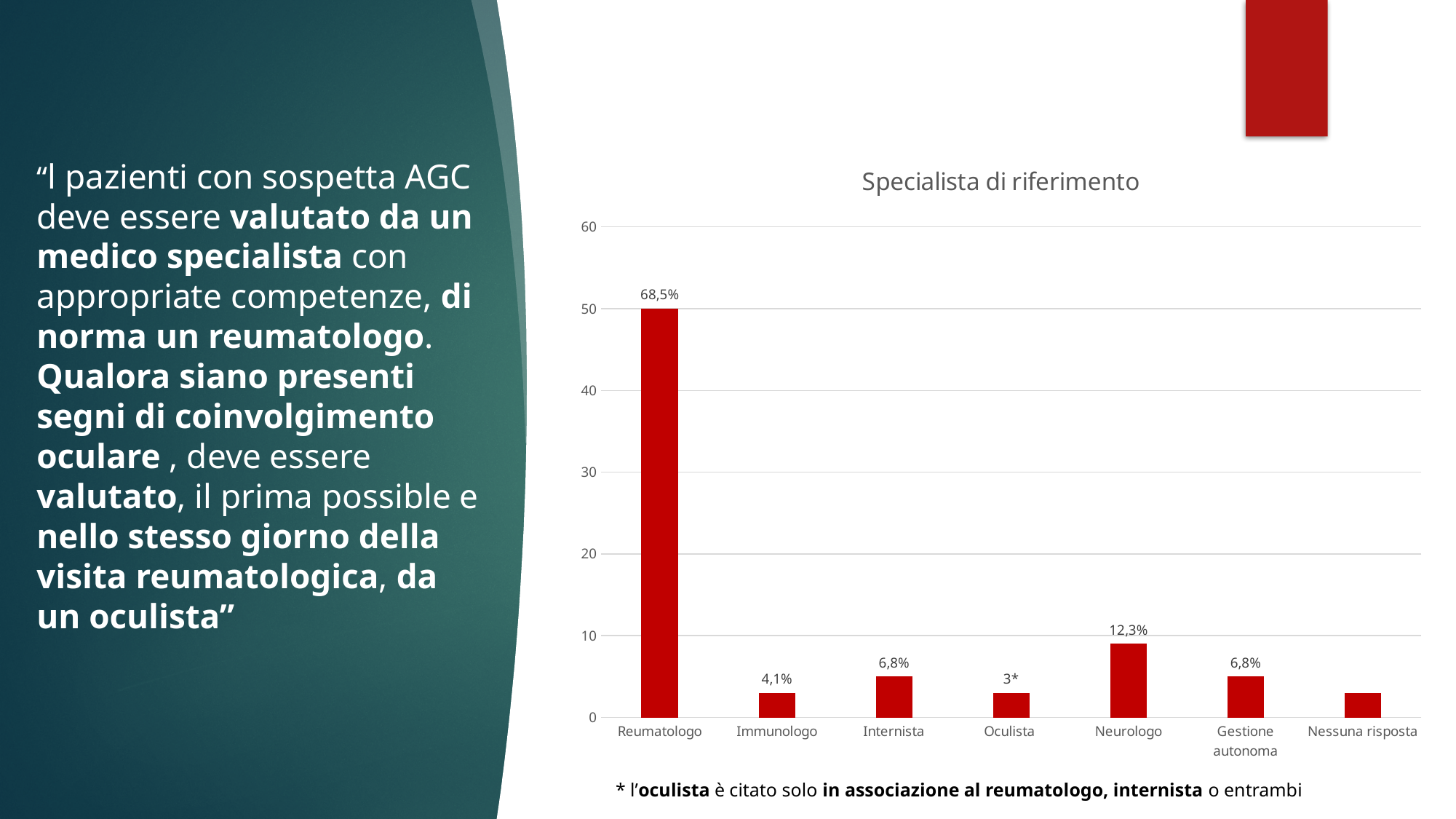
What is the data label shown for Immunologo? 4,1% Is the bar for Reumatologo greater or less than 40 on the axis? greater What is the data label shown for Neurologo? 12,3% How many categories are shown on the x axis? 7 What is the difference between the labelled values for Reumatologo and Neurologo? 56,2% What is the data label shown above the Oculista bar? 3* Which is larger, the value for Neurologo or the value for Internista? Neurologo Is the bar for Nessuna risposta greater or less than 10 on the axis? less What is the data label shown for Reumatologo? 68,5% What is the data label shown for Internista? 6,8% What is the title of the chart? Specialista di riferimento Which category has the highest bar? Reumatologo